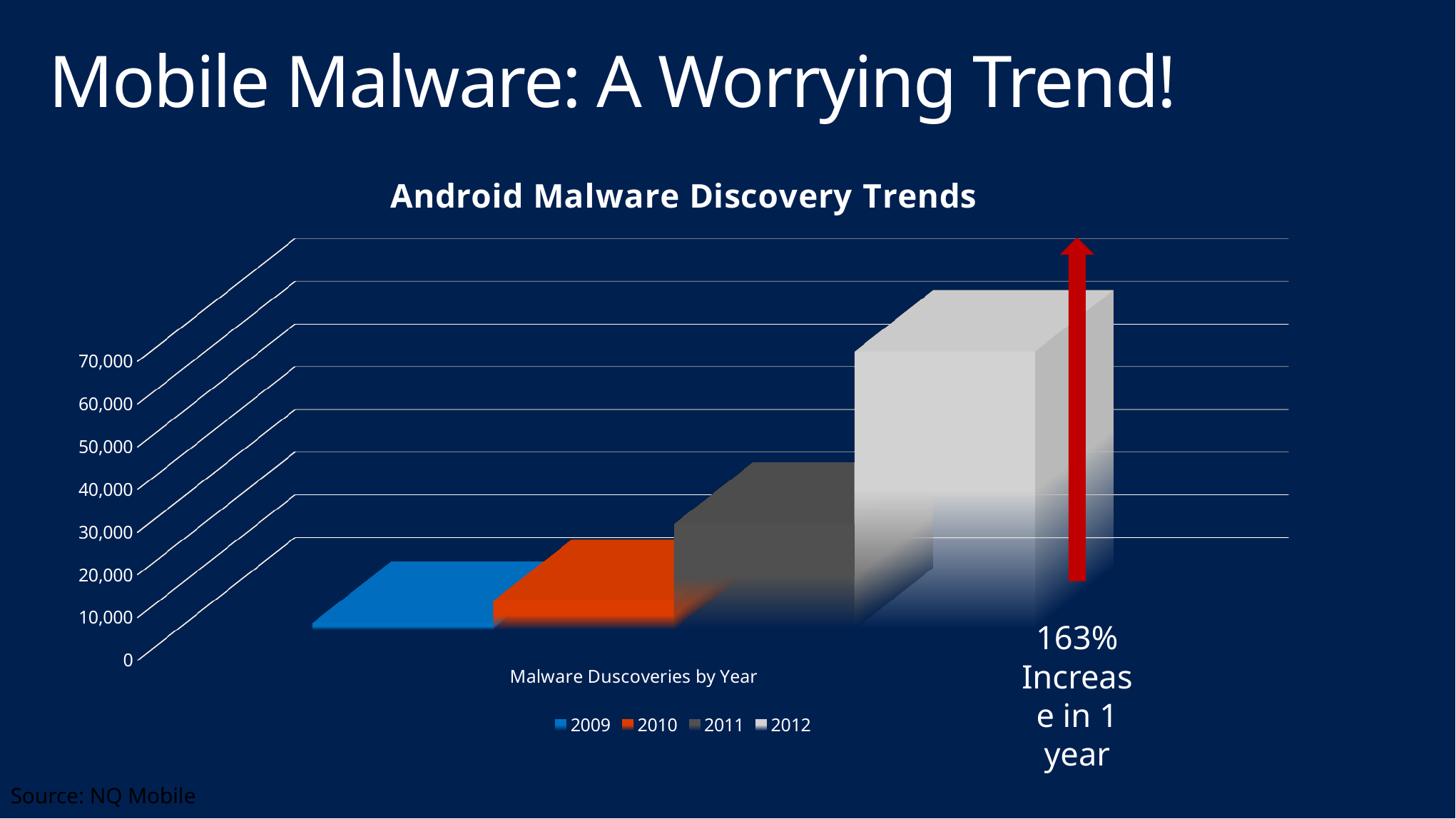
Do the values rise or fall from 2009 to 2012? rise Is the value for 2012 greater or less than 40,000? greater Is the value for 2009 greater or less than 30,000? less Which year has the lowest value in the chart? 2009 How many series does the legend list? 4 How many bars are plotted in the chart? 4 Which year has the highest value in the chart? 2012 Is the value for 2010 greater or less than 40,000? less What percentage increase in one year does the annotation next to the 2012 bar state? 163% What is the title of the chart? Android Malware Discovery Trends Which is larger, the value for 2011 or the value for 2010? 2011 What kind of chart is shown on the slide? bar chart